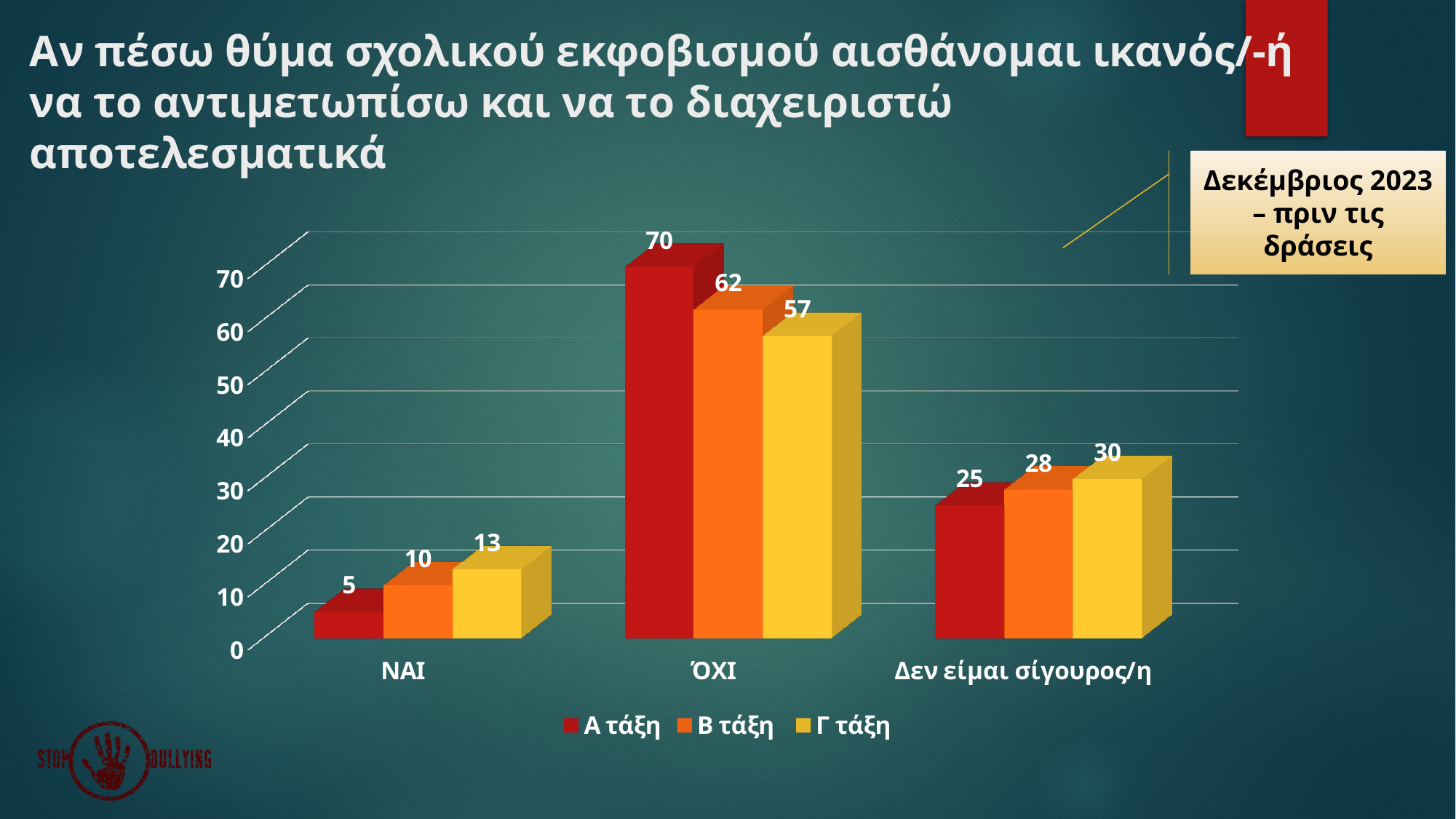
What is the value for Γ τάξη in the ΝΑΙ category? 13 What does the text box at the top right of the slide say? Δεκέμβριος 2023 – πριν τις δράσεις Which is larger: the Γ τάξη value for ΝΑΙ or the Α τάξη value for Δεν είμαι σίγουρος/η? Α τάξη value for Δεν είμαι σίγουρος/η What kind of chart is shown on the slide? Bar chart Which category has the highest value for Α τάξη? ΌΧΙ Which category has the lowest value for Β τάξη? ΝΑΙ What is the difference between the Α τάξη and Γ τάξη values in the ΌΧΙ category? 13 Which series is shown in yellow in the legend? Γ τάξη How many series does the legend list? 3 What is the value for Β τάξη in the Δεν είμαι σίγουρος/η category? 28 How many categories are shown on the x axis? 3 What is the value for Α τάξη in the ΌΧΙ category? 70